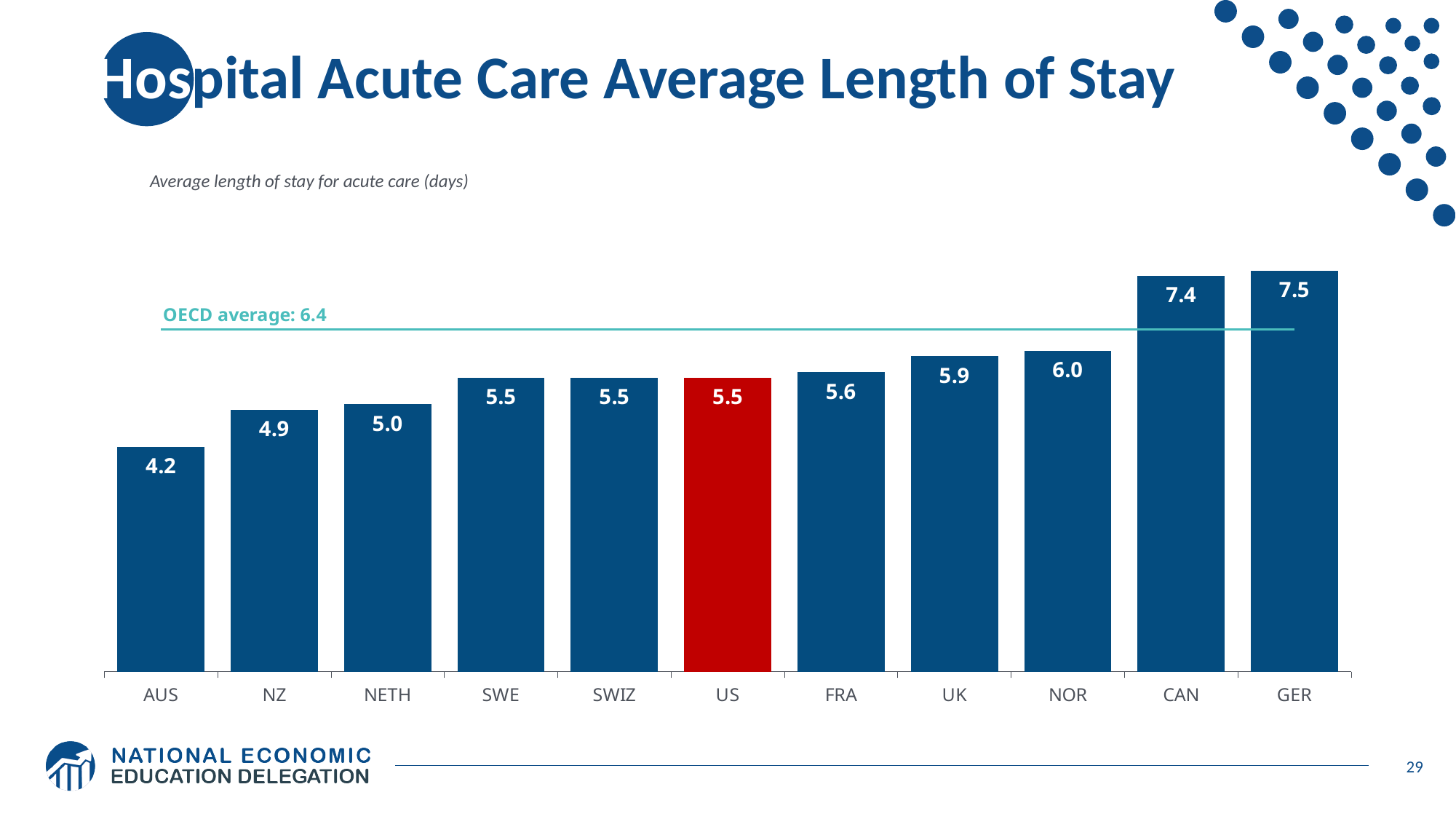
What kind of chart is shown on the slide? Bar chart How many countries are shown in the chart? 11 What is the difference between the values for GER and AUS? 3.3 What is the average length of stay for acute care in the US? 5.5 What is the value shown for AUS? 4.2 Which country's bar is coloured red? US Which country has the lowest average length of stay? AUS Which country has the highest average length of stay? GER What is the OECD average shown on the chart? 6.4 What is the average length of stay for acute care in Germany (GER)? 7.5 Which has a higher average length of stay, UK or NOR? NOR What is the difference between the values for CAN and US? 1.9